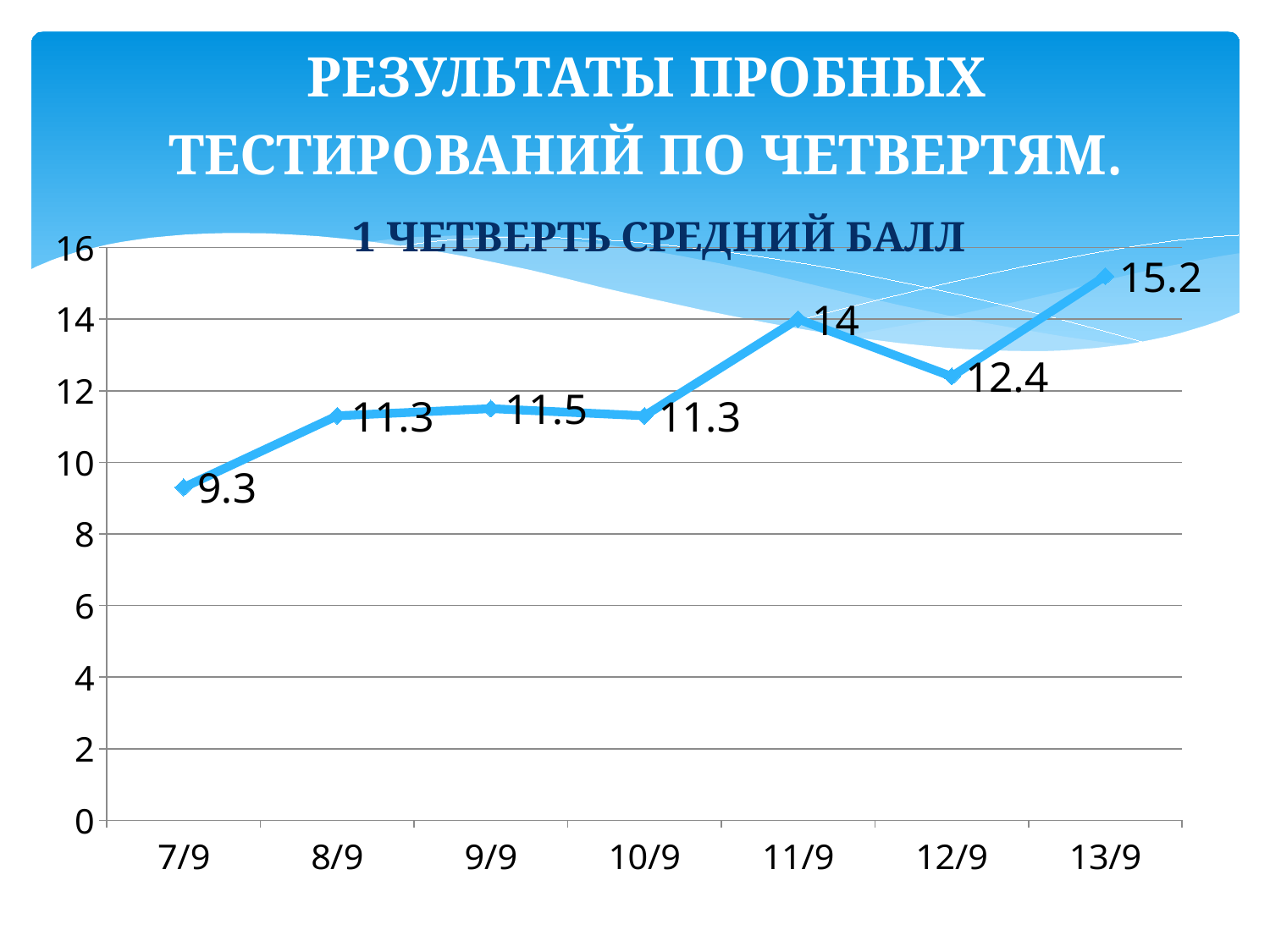
Which is larger, the value for 9/9 or the value for 12/9? 12/9 How many data points are plotted on the chart? 7 What kind of chart is shown on the slide? line chart What is the value for 11/9? 14 Which date has the lowest value? 7/9 What is the difference between the values for 13/9 and 7/9? 5.9 Which date has the highest value? 13/9 What is the value for 12/9? 12.4 What is the value for 13/9? 15.2 What is the value for 7/9? 9.3 What is the title of the chart? 1 ЧЕТВЕРТЬ СРЕДНИЙ БАЛЛ What is the difference between the values for 11/9 and 12/9? 1.6